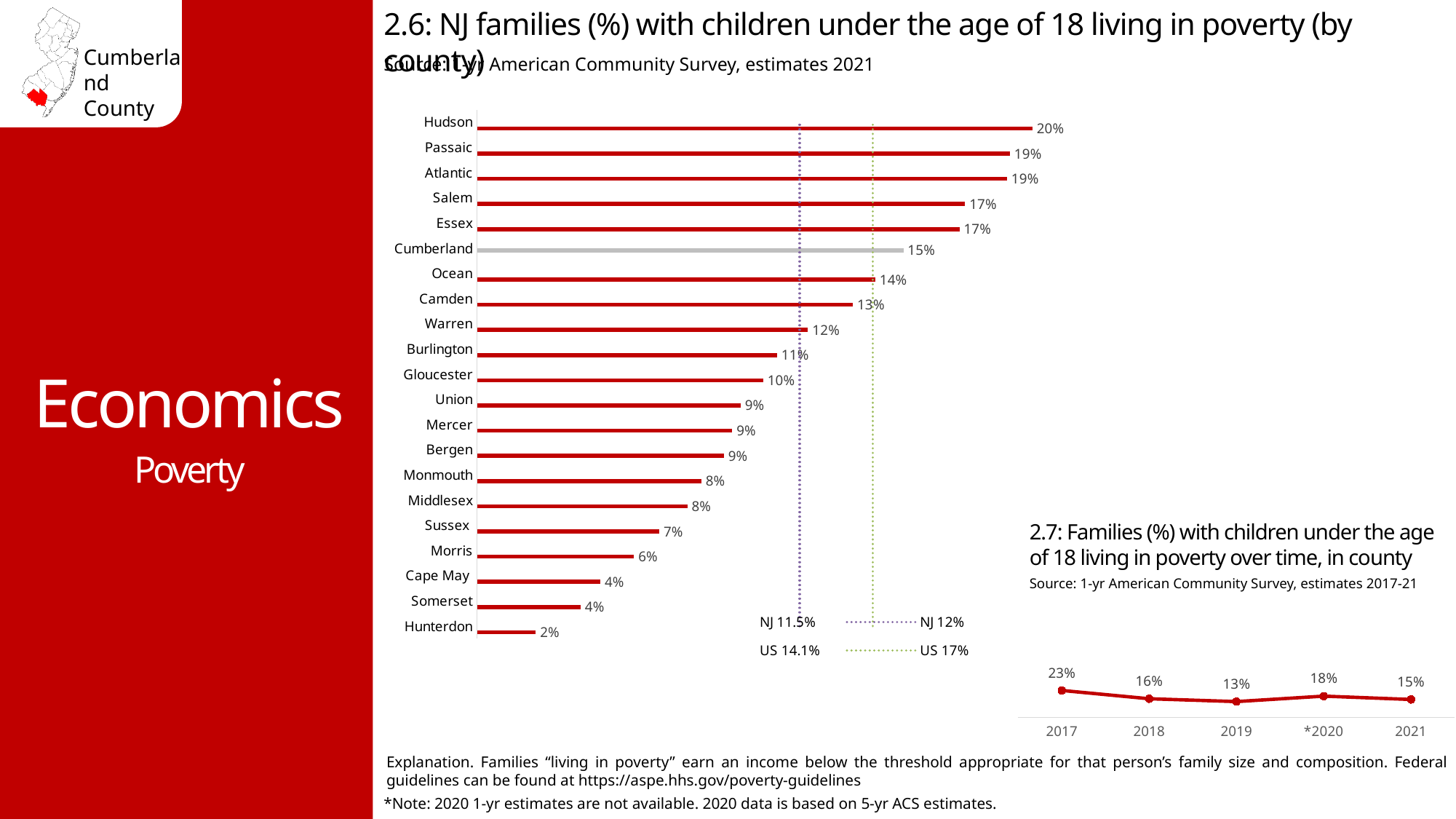
In chart 2.6, how many counties are plotted? 21 In chart 2.6, what is the value for Camden? 13% In chart 2.6 (NJ families with children under 18 living in poverty by county), what is the value for Cumberland? 15% In chart 2.6, which county has a larger value, Salem or Ocean? Salem In chart 2.7, what is the difference between the values for 2017 and 2021? 8% What kind of chart is chart 2.6? Bar chart In chart 2.6, which county has the lowest percentage of families with children living in poverty? Hunterdon In chart 2.6, what is the difference between the values for Hudson and Cumberland? 5% In chart 2.7 (families with children under 18 living in poverty over time, in county), what is the value for 2017? 23% In chart 2.6, which county has the highest percentage of families with children living in poverty? Hudson In chart 2.7, which year has the lowest value? 2019